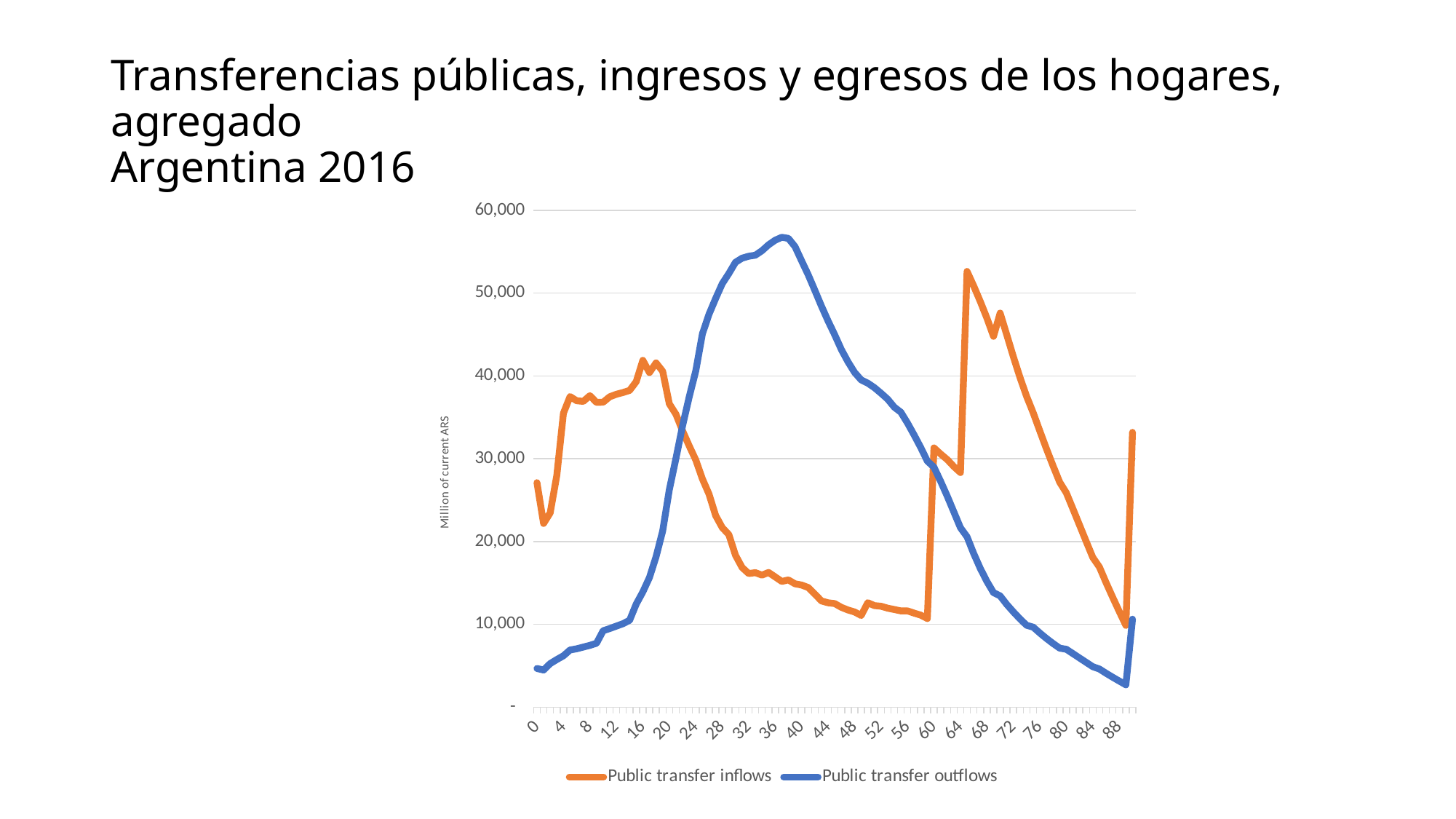
What kind of chart is shown on the slide? line chart At age 72, which series has the larger value, Public transfer inflows or Public transfer outflows? Public transfer inflows Is the value of Public transfer outflows at age 0 greater or less than 10,000? less What are the two series named in the legend? Public transfer inflows and Public transfer outflows At age 40, which series has the larger value, Public transfer inflows or Public transfer outflows? Public transfer outflows Do the values of Public transfer outflows rise or fall between age 40 and age 88? fall How many series does the legend list? 2 What is the label on the vertical axis? Million of current ARS Is the value of Public transfer inflows at age 36 greater or less than 20,000? less Is the value of Public transfer inflows at age 80 greater or less than 30,000? less Which series reaches the higher peak value, Public transfer inflows or Public transfer outflows? Public transfer outflows